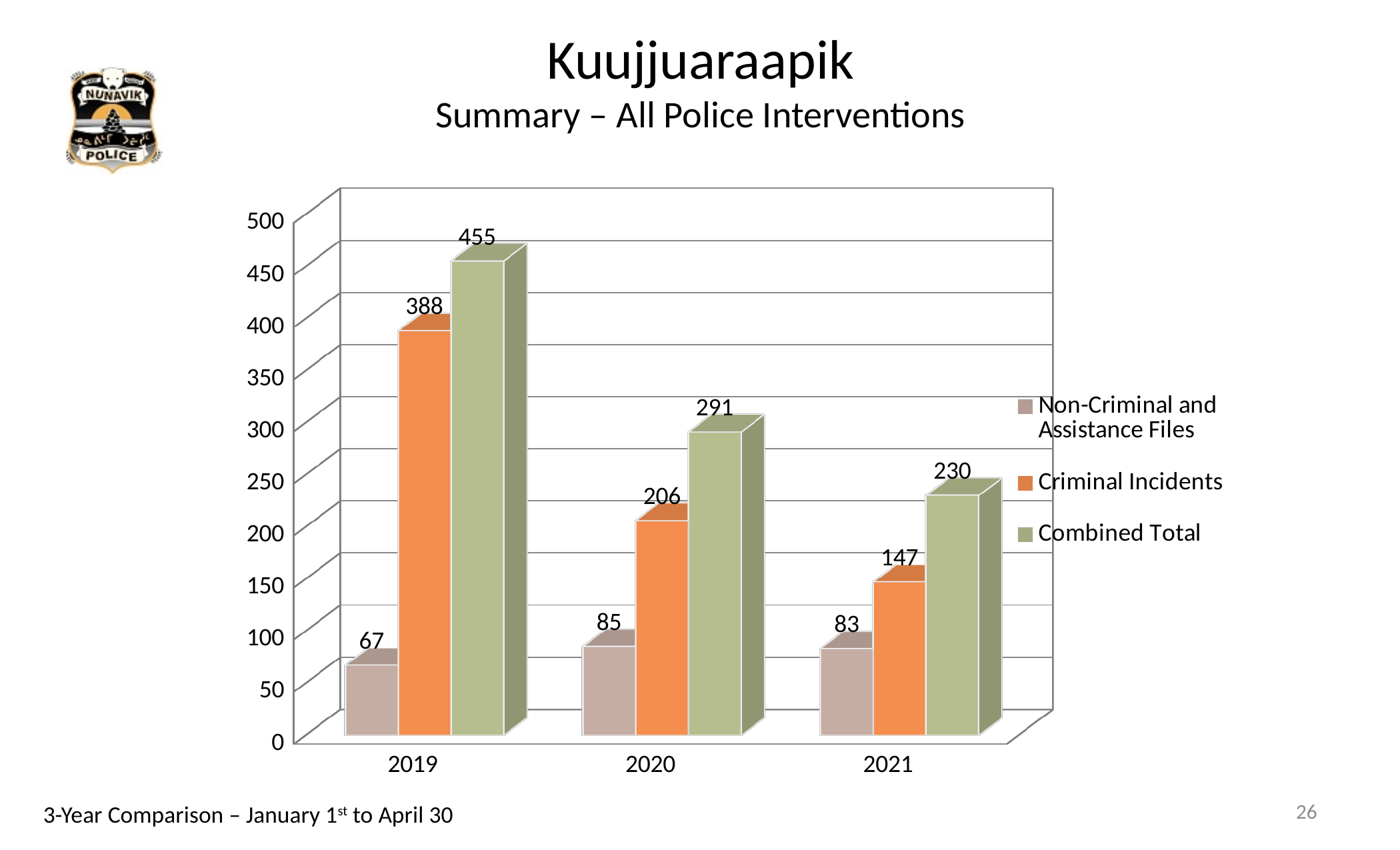
Do the Combined Total values rise or fall from 2019 to 2021? Fall How many series does the legend list? 3 Which is larger: Criminal Incidents in 2021 or Non-Criminal and Assistance Files in 2021? Criminal Incidents in 2021 Is the Combined Total for 2020 greater or less than 250? greater What is the value for Criminal Incidents in 2019? 388 What is the value for Non-Criminal and Assistance Files in 2020? 85 What kind of chart is shown on the slide? Bar chart How many years are shown on the x axis? 3 Which year has the lowest value for Non-Criminal and Assistance Files? 2019 What is the Combined Total for 2021? 230 Which year has the highest Combined Total? 2019 What is the difference between Criminal Incidents in 2019 and 2020? 182